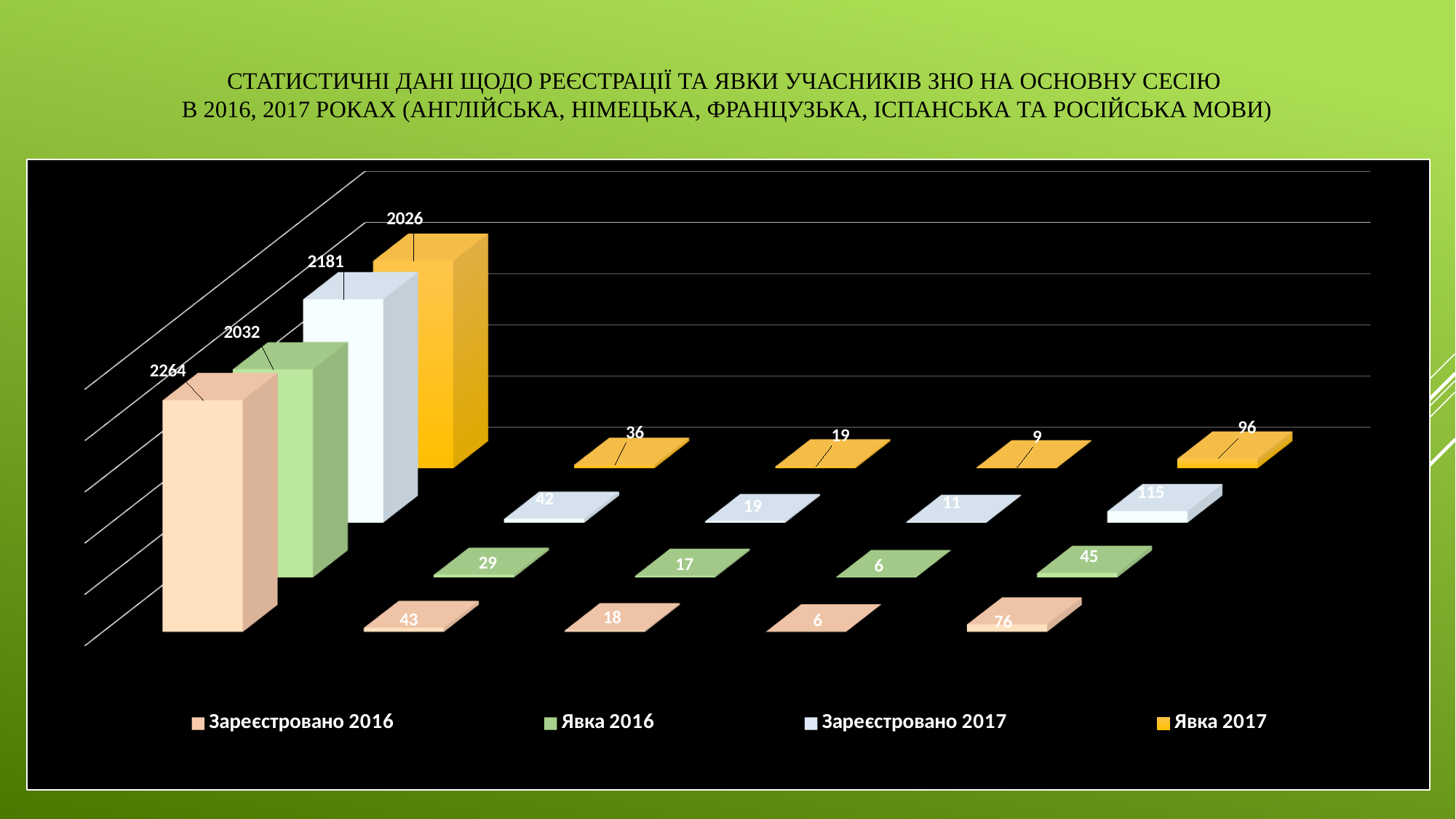
What is the highest value in the Зареєстровано 2016 series? 2264 Which is larger: the highest value of Зареєстровано 2016 or the highest value of Зареєстровано 2017? Зареєстровано 2016 What is the difference between the highest value of Зареєстровано 2017 (2181) and the highest value of Явка 2017 (2026)? 155 How many series does the legend list? 4 What is the difference between the highest value of Зареєстровано 2016 (2264) and the highest value of Явка 2016 (2032)? 232 What is the lowest value in the Зареєстровано 2017 series? 11 What kind of chart is shown on the slide? bar chart How many categories (groups of bars) are plotted in the chart? 5 Which series is shown in orange/yellow in the legend? Явка 2017 What is the highest value in the Явка 2017 series? 2026 What is the value of the Зареєстровано 2017 series for the last (rightmost) category? 115 What is the lowest value in the Явка 2017 series? 9